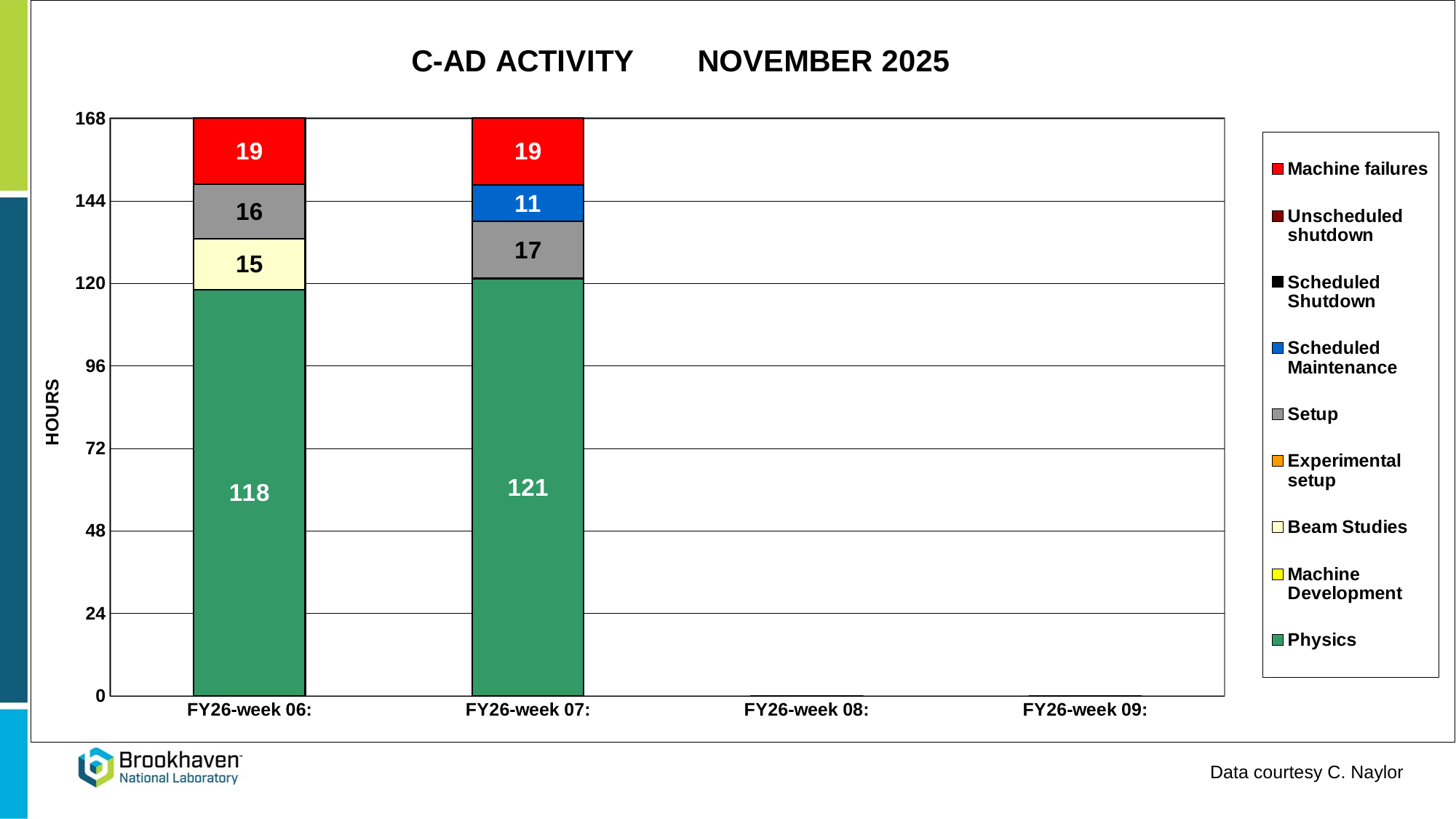
How many series does the legend list? 9 What is the Physics value for FY26-week 07? 121 What is the Beam Studies value for FY26-week 06? 15 What is the Machine failures value for FY26-week 06? 19 What is the Setup value for FY26-week 07? 17 What is the difference between the Physics values for FY26-week 07 and FY26-week 06? 3 What is the label of the y axis? HOURS What kind of chart is shown on the slide? Stacked bar chart What is the Scheduled Maintenance value for FY26-week 07? 11 What is the total of the stacked bar for FY26-week 06? 168 Which is larger, the Setup value for FY26-week 06 or for FY26-week 07? FY26-week 07 What is the Physics value for FY26-week 06? 118